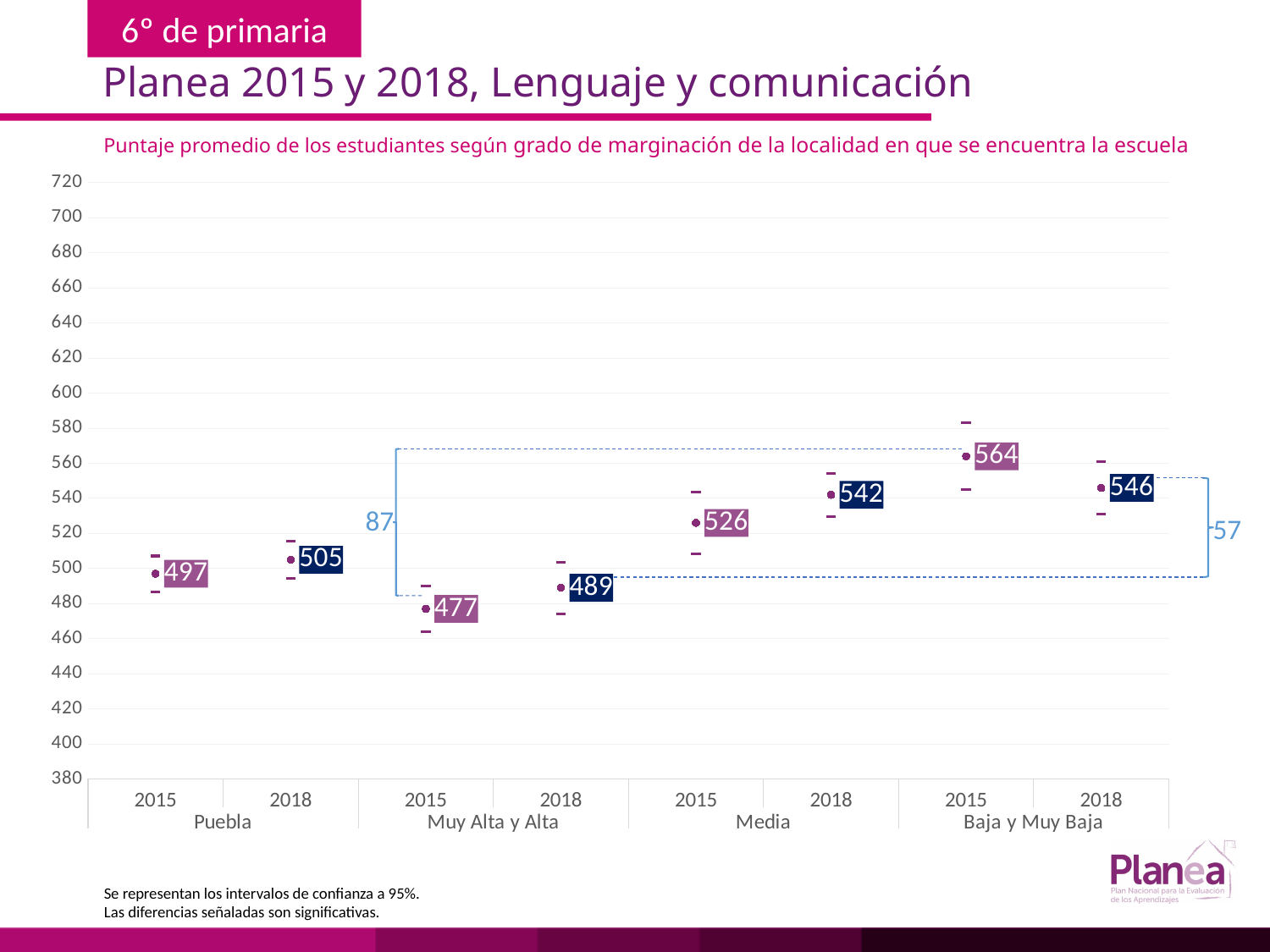
Which group and year has the highest average score? Baja y Muy Baja, 2015 What is the difference between the 2015 score for Baja y Muy Baja and the 2015 score for Muy Alta y Alta? 87 What is the difference between the 2018 and 2015 scores for Media? 16 What is the subtitle of the chart? Puntaje promedio de los estudiantes según grado de marginación de la localidad en que se encuentra la escuela How many marginalization groups are shown on the x axis? 4 What is the average score for Baja y Muy Baja in 2015? 564 What is the average score for Media in 2018? 542 Did the score for Baja y Muy Baja rise or fall from 2015 to 2018? fall Which group and year has the lowest average score? Muy Alta y Alta, 2015 What is the average score for Puebla in 2015? 497 Which is larger, the 2018 score for Baja y Muy Baja or the 2018 score for Media? Baja y Muy Baja 2018 What is the average score for Muy Alta y Alta in 2018? 489